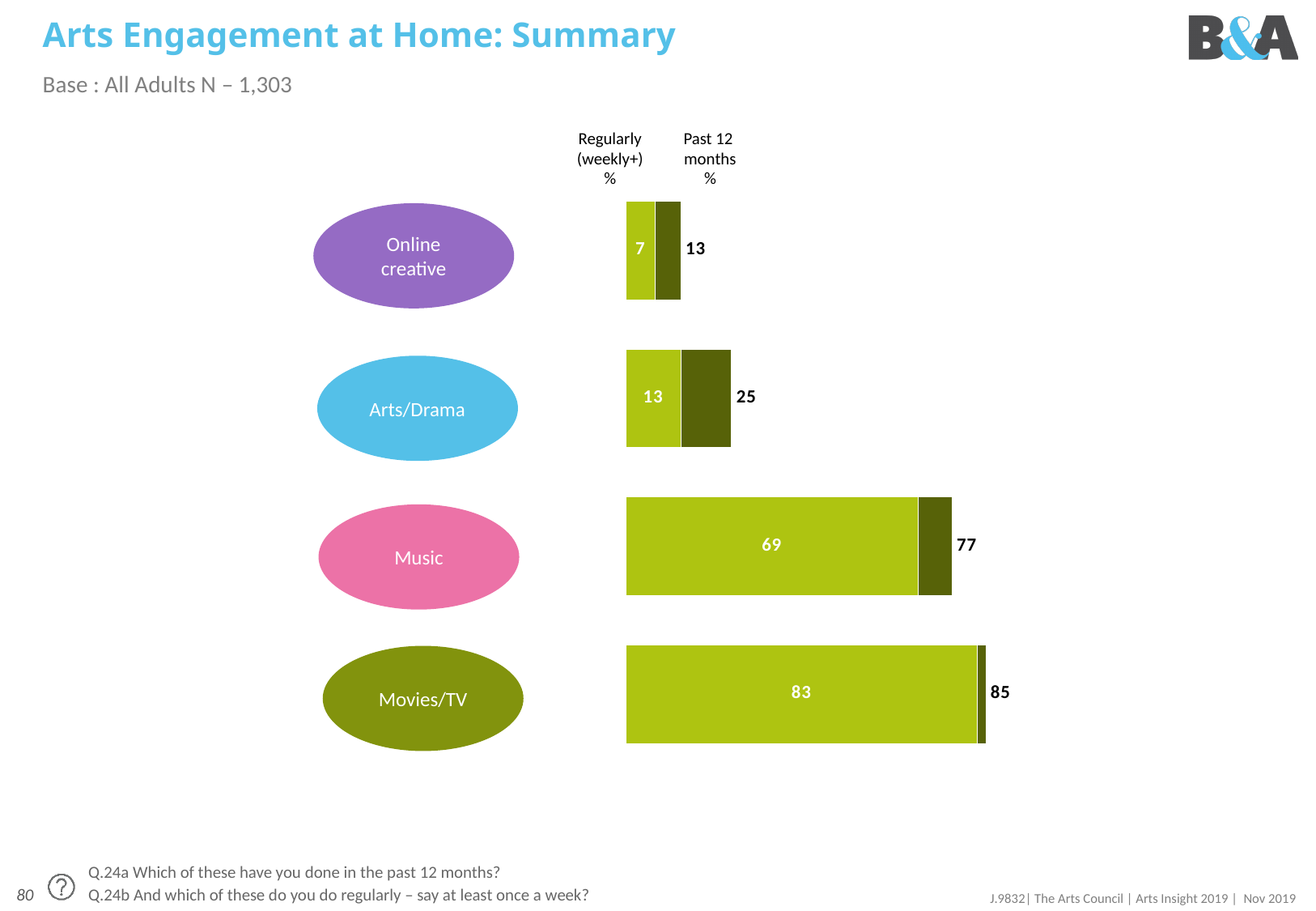
Which category has the highest Past 12 months % value? Movies/TV What is the difference between the Regularly (weekly+) % values for Movies/TV and Music? 14 What is the Regularly (weekly+) % value for Online creative? 7 How many categories are shown in the chart? 4 What is the Past 12 months % value for Movies/TV? 85 Which is larger: the Past 12 months % value for Music or for Arts/Drama? Music Which category has the lowest Regularly (weekly+) % value? Online creative How many series does the chart show? 2 What is the Past 12 months % value for Arts/Drama? 25 What kind of chart is shown on the slide? Bar chart What is the difference between the Past 12 months % and Regularly (weekly+) % values for Arts/Drama? 12 What is the Regularly (weekly+) % value for Music? 69